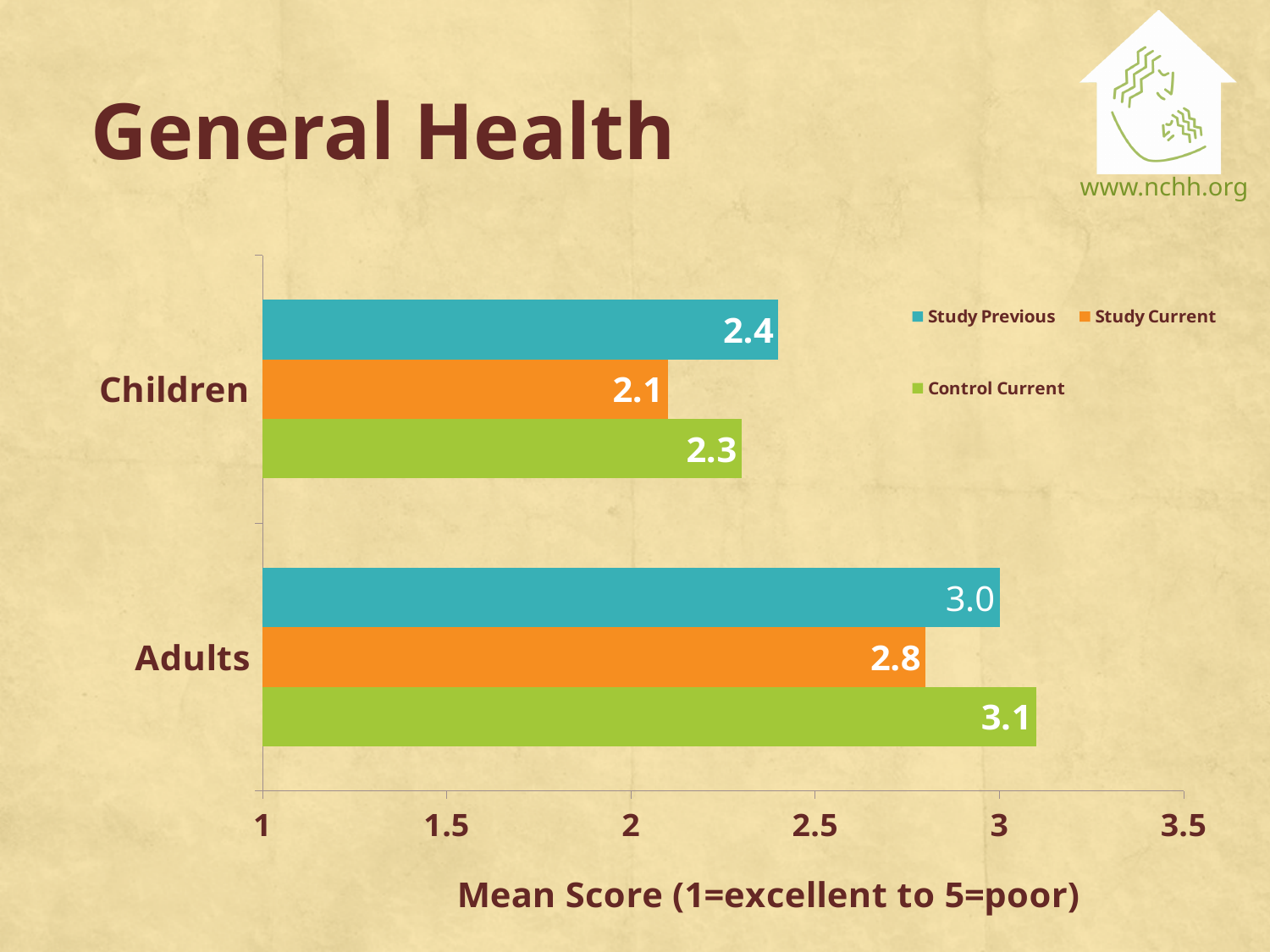
What is the Study Current mean score for Adults? 2.8 How many categories are shown on the chart? 2 How many series does the legend list? 3 What is the Control Current mean score for Children? 2.3 What is the label of the horizontal axis? Mean Score (1=excellent to 5=poor) What kind of chart is shown on the slide? Bar chart What is the Study Previous mean score for Children? 2.4 Which is larger for Children: the Study Previous score or the Control Current score? Study Previous Which series has the lowest mean score for Children? Study Current Is the Study Current mean score for Adults greater or less than 2.5? greater What is the difference between the Study Previous and Study Current mean scores for Adults? 0.2 Which series has the highest mean score for Adults? Control Current